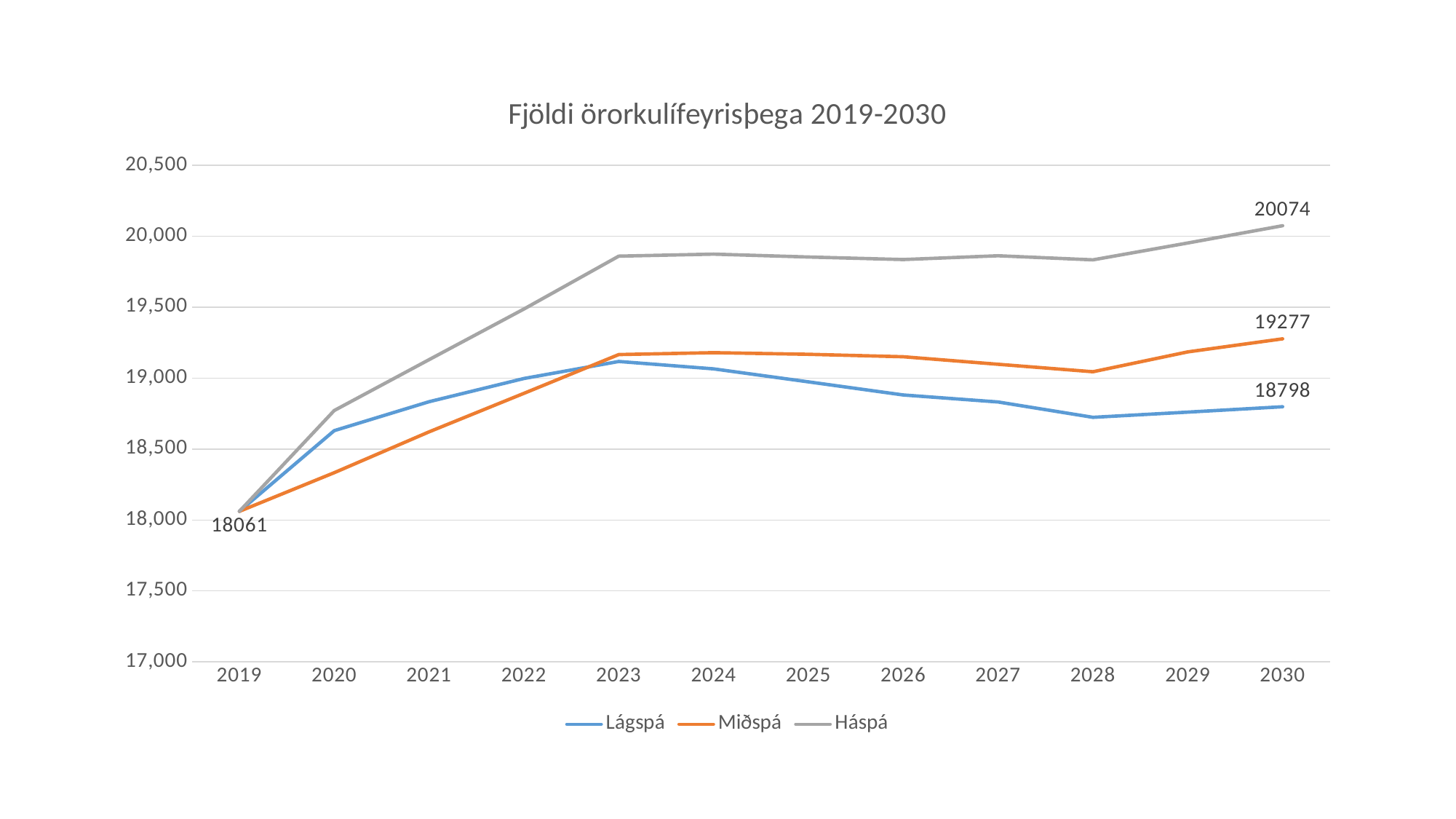
How many years are shown on the x axis? 12 What is the value shown for 2019? 18061 What kind of chart is shown on the slide? line chart Is the value for Lágspá in 2028 greater or less than 19,000? less How many series does the legend list? 3 What is the difference between the Háspá and Lágspá values in 2030? 1276 Is the value for Háspá in 2023 greater or less than 19,500? greater What is the value for Háspá in 2030? 20074 What is the value for Lágspá in 2030? 18798 What is the title of the chart? Fjöldi örorkulífeyrisþega 2019-2030 What is the value for Miðspá in 2030? 19277 Which series has the highest value in 2030? Háspá